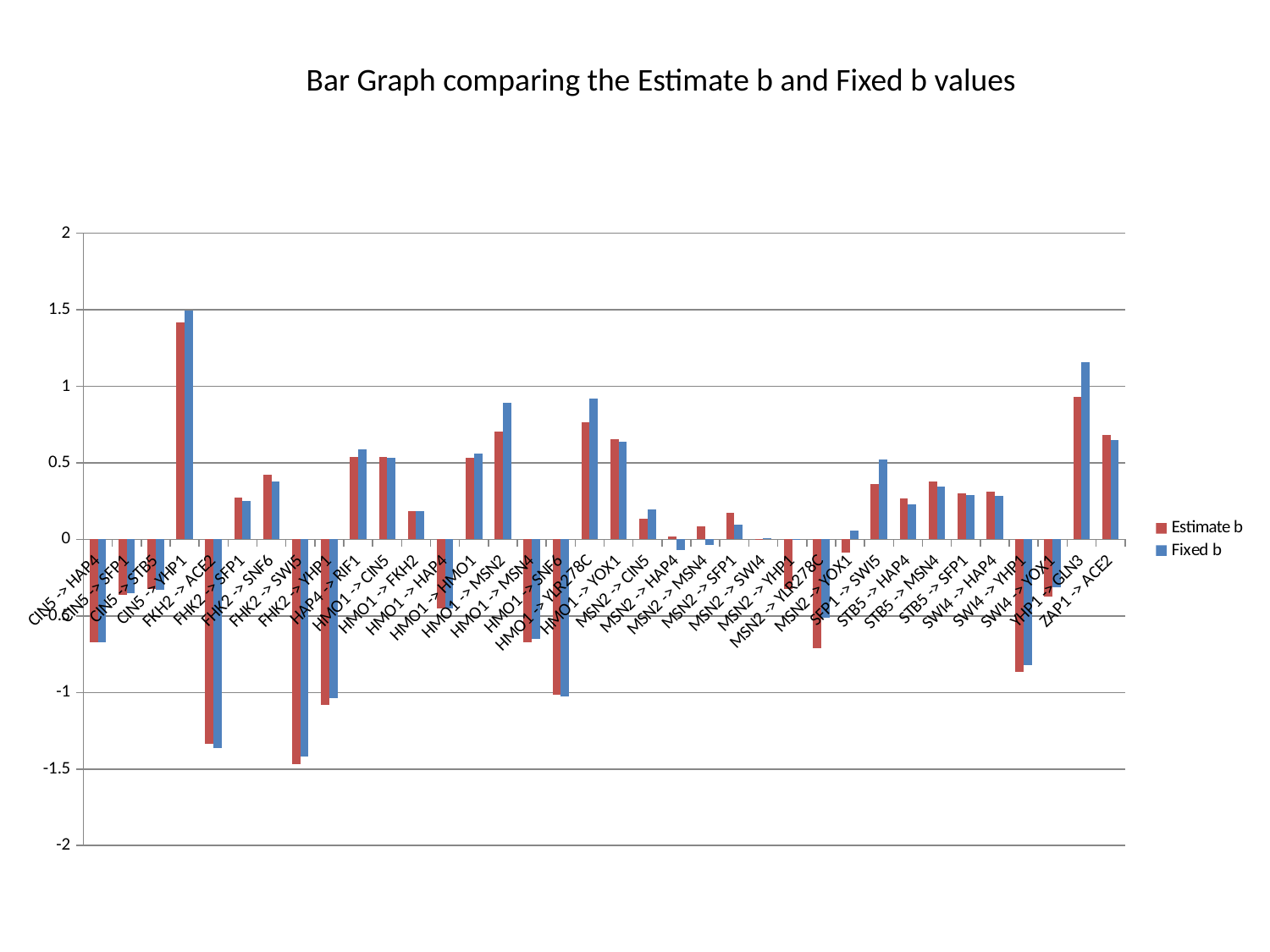
What are the two series named in the legend? Estimate b and Fixed b For YHP1 -> GLN3, which is larger: the Estimate b value or the Fixed b value? Fixed b Is the Fixed b value for CIN5 -> YHP1 greater or less than 1? greater Which category has the highest Estimate b value? CIN5 -> YHP1 Is the Estimate b value for FKH2 -> ACE2 greater or less than -1? less What is the title of the chart? Bar Graph comparing the Estimate b and Fixed b values For HMO1 -> MSN2, which is larger: the Estimate b value or the Fixed b value? Fixed b Is the Estimate b value for SWI4 -> YHP1 greater or less than -0.5? less Which category has the lowest Estimate b value? FHK2 -> SWI5 What kind of chart is shown on the slide? Bar chart How many series does the legend list? 2